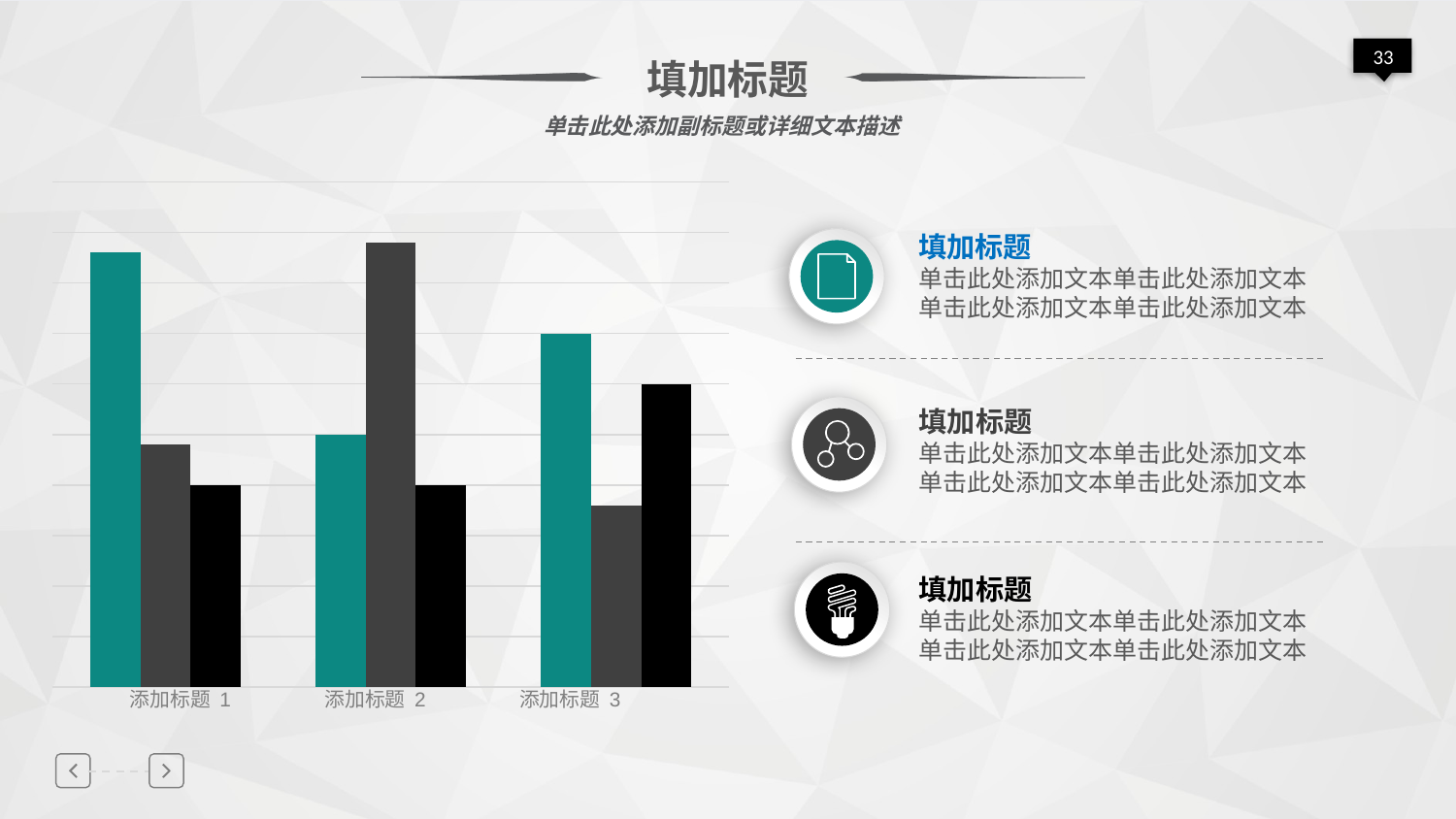
How many bars are plotted for each category in the chart? 3 In which category is the dark grey bar the tallest? 添加标题 2 How many categories are shown on the x axis of the chart? 3 In which category is the teal bar the shortest? 添加标题 2 Does the teal bar rise or fall from 添加标题 1 to 添加标题 2? fall In category 添加标题 2, which bar is taller, the dark grey bar or the black bar? the dark grey bar In which category is the dark grey bar the shortest? 添加标题 3 In category 添加标题 1, which bar is taller, the teal bar or the dark grey bar? the teal bar In which category is the black bar the tallest? 添加标题 3 What kind of chart is shown on the slide? bar chart In which category is the teal bar the tallest? 添加标题 1 How many bars are plotted in total in the chart? 9